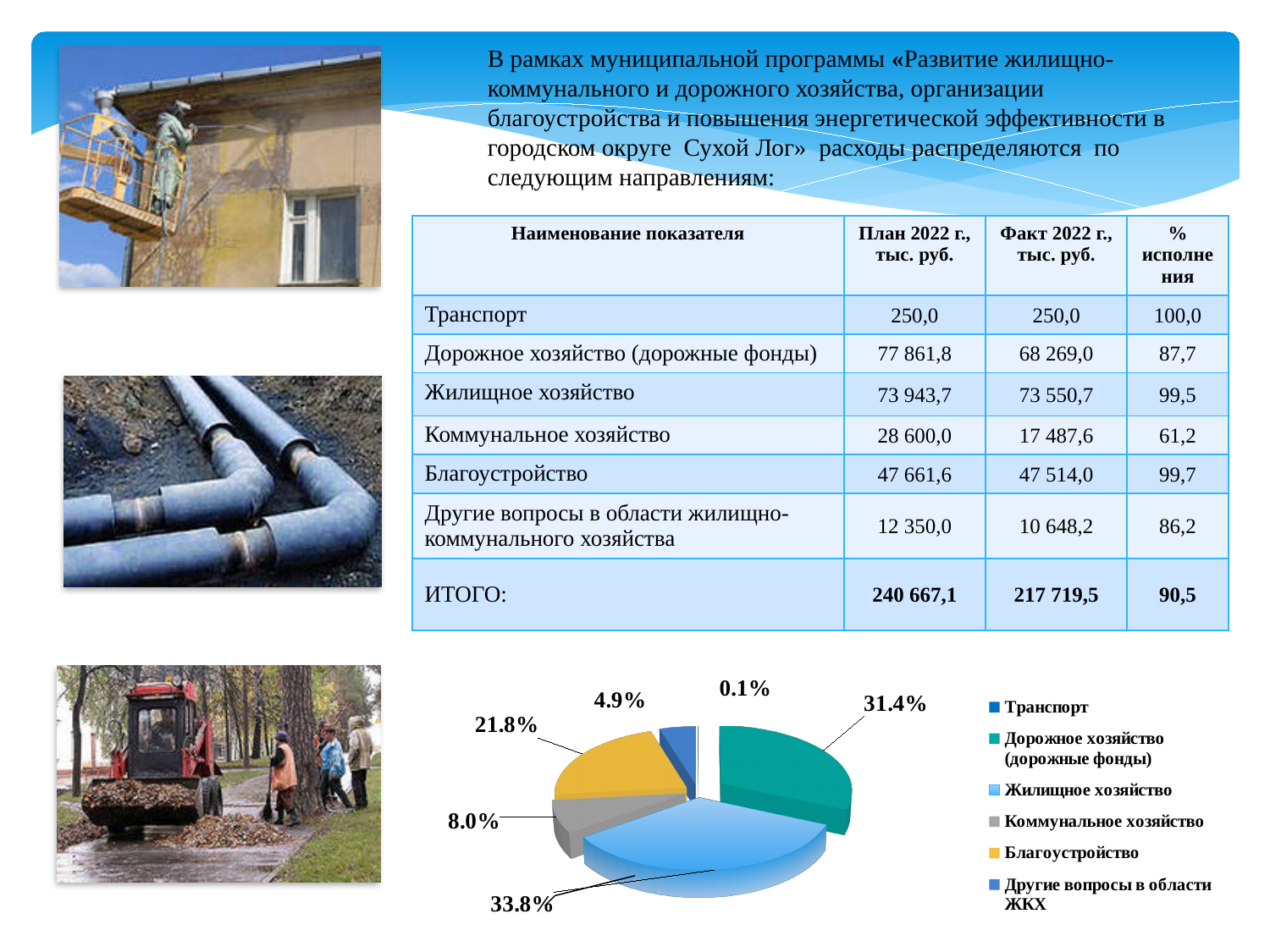
In the pie chart, what share is shown for Другие вопросы в области ЖКХ? 4.9% What kind of chart is shown at the bottom of the slide? pie chart In the pie chart, which slice is larger: Благоустройство or Другие вопросы в области ЖКХ? Благоустройство Which category has the largest slice in the pie chart? Жилищное хозяйство In the pie chart, what share is shown for Жилищное хозяйство? 33.8% In the pie chart, what share is shown for Коммунальное хозяйство? 8.0% In the pie chart, what is the difference in percentage points between Благоустройство and Коммунальное хозяйство? 13.8 Which category has the smallest slice in the pie chart? Транспорт How many categories does the legend of the pie chart list? 6 In the pie chart, what share is shown for Благоустройство? 21.8% In the pie chart, what share is shown for Транспорт? 0.1% In the pie chart, what share is shown for Дорожное хозяйство (дорожные фонды)? 31.4%